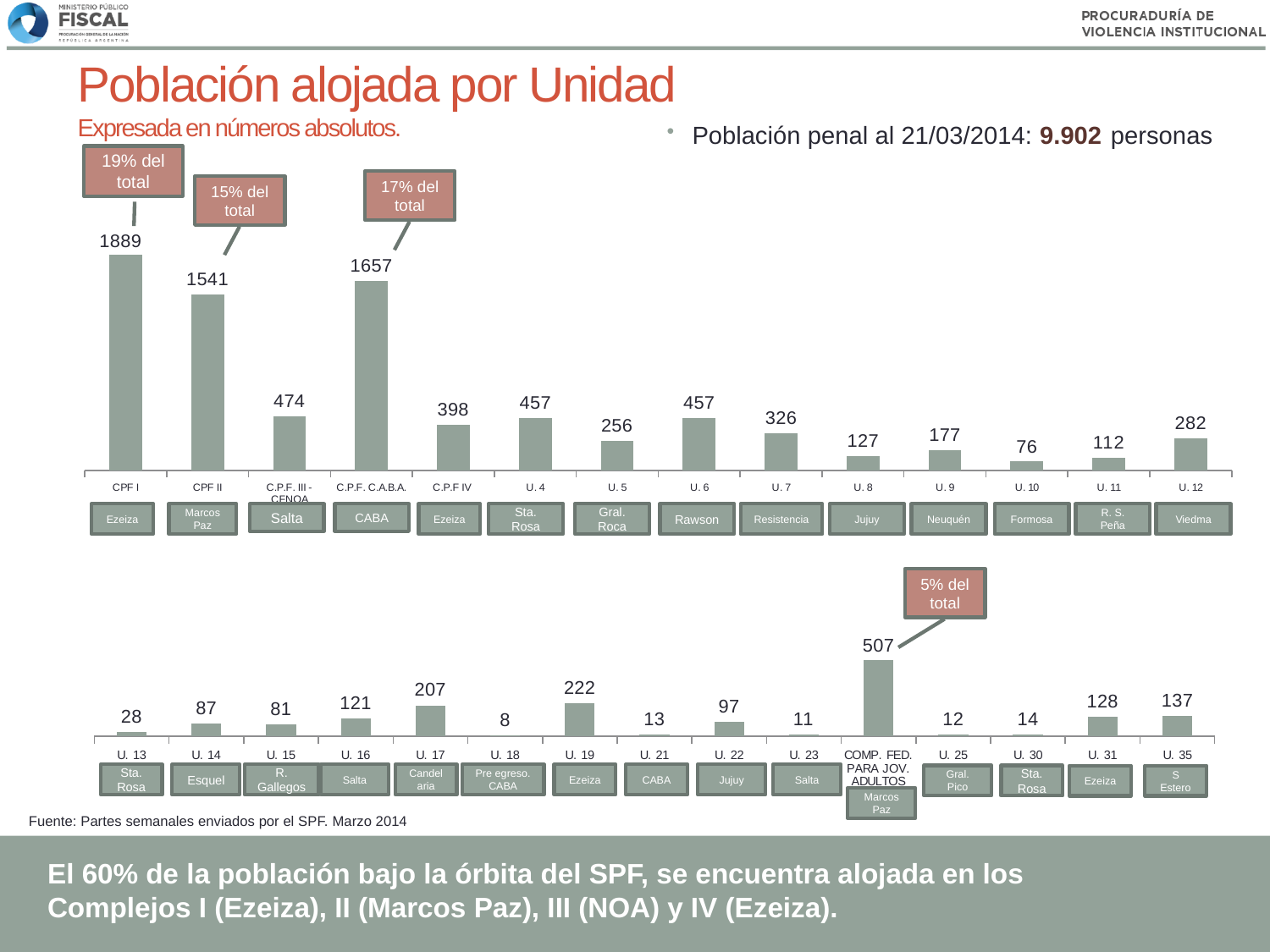
In the top chart, what is the difference between CPF I and CPF II? 348 In the top chart, what is the value for CPF I? 1889 In the top chart, which unit has the lowest value? U. 10 In the top chart, which unit has the highest value? CPF I What type of chart is used on this slide? Bar chart In the bottom chart, what is the value for U. 19? 222 In the top chart, what is the value for C.P.F. C.A.B.A.? 1657 How many units are shown in the bottom chart? 15 In the bottom chart, which unit has the highest value? COMP. FED. PARA JOV. ADULTOS In the bottom chart, which unit has the lowest value? U. 18 In the top chart, which is larger, U. 7 or U. 12? U. 7 How many units are shown in the top chart? 14